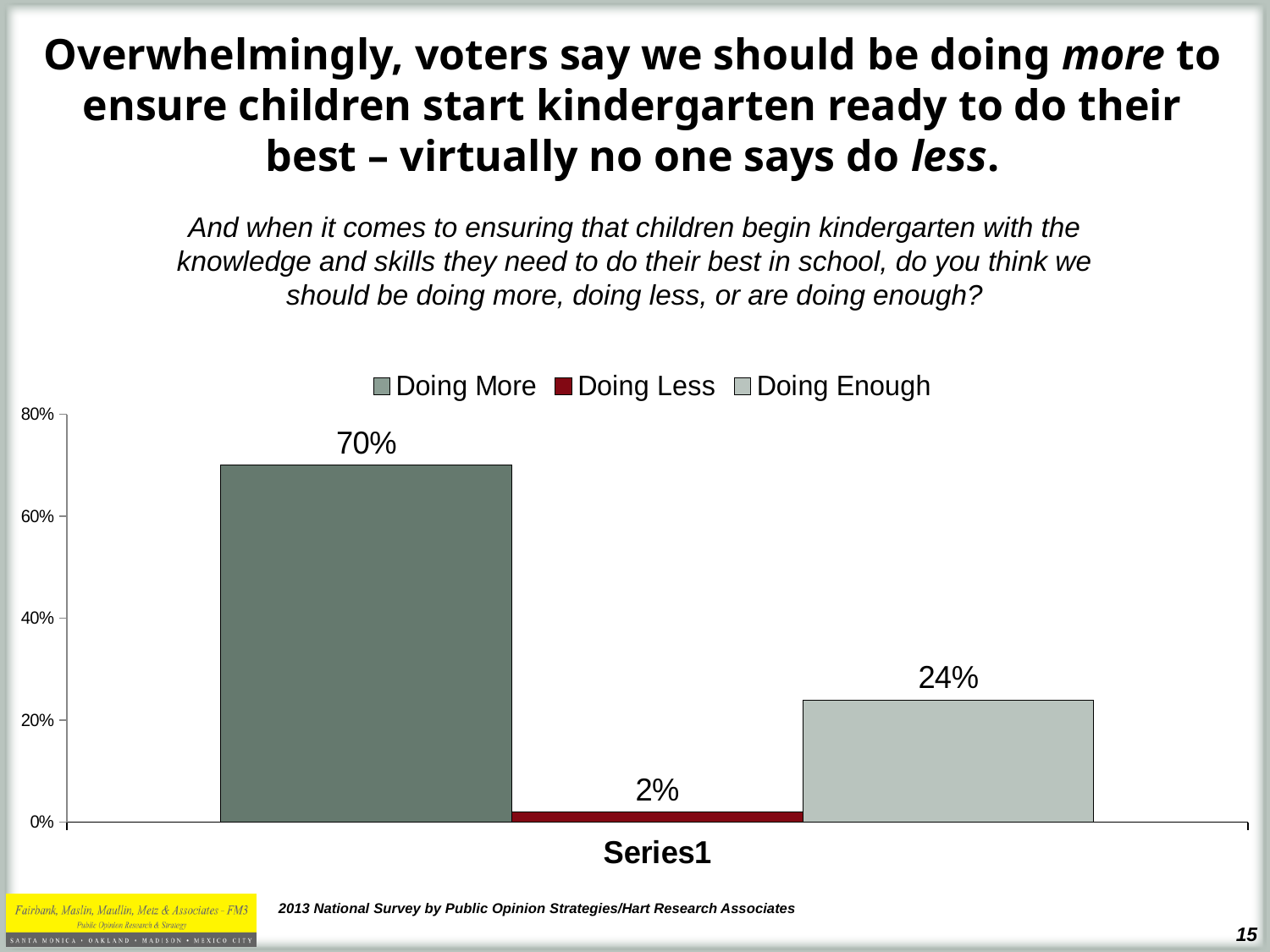
What colour is the Doing Less bar? dark red Which is larger, the value for Doing Enough or the value for Doing Less? Doing Enough What percentage of voters say we should be doing more? 70% What is the difference in percentage points between Doing Enough and Doing Less? 22 What is the difference in percentage points between Doing More and Doing Enough? 46 How many series does the legend list? 3 Which response has the lowest percentage? Doing Less Which response has the highest percentage? Doing More What percentage of voters say we should be doing less? 2% What percentage of voters say we are doing enough? 24% What kind of chart is shown on the slide? bar chart Is the value for Doing Enough greater or less than 40%? less